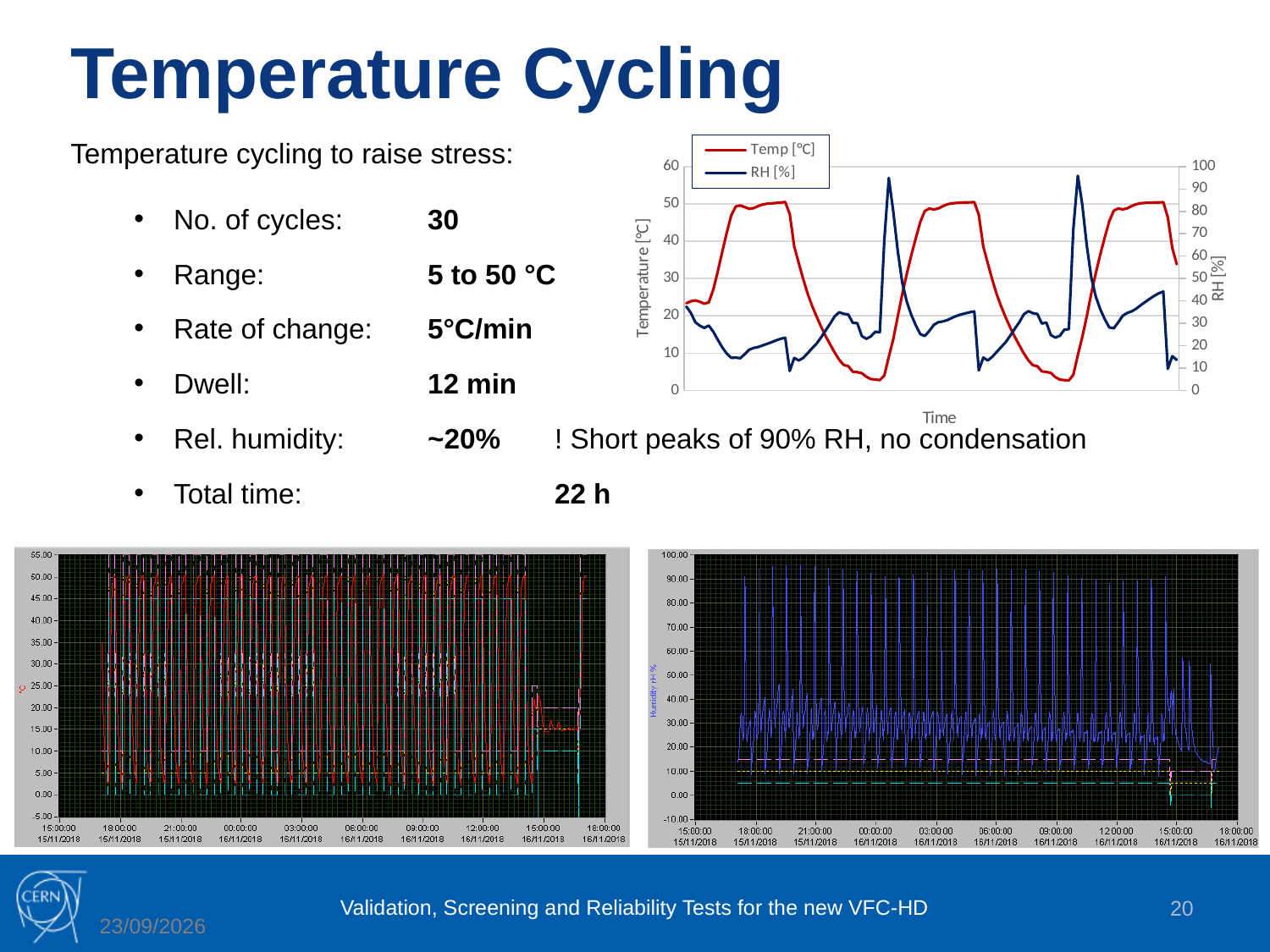
How many series does the legend of the top-right chart list? 2 What is the lowest tick value on the y axis of the bottom-right chart? -10.00 How many charts are shown on the slide? 3 In the bottom-right chart, are the tallest blue spikes greater or less than 80.00 on the y axis? greater In the top-right chart, are the lowest values of the Temp [°C] series greater or less than 10 on the left-hand axis? less In the top-right chart, which series is drawn in red? Temp [°C] What is the label of the x axis of the top-right chart? Time What kind of chart is the top-right chart with the Temp [°C] and RH [%] legend? line chart In the top-right chart, are the high plateaus of the Temp [°C] series greater or less than 40 on the left-hand axis? greater